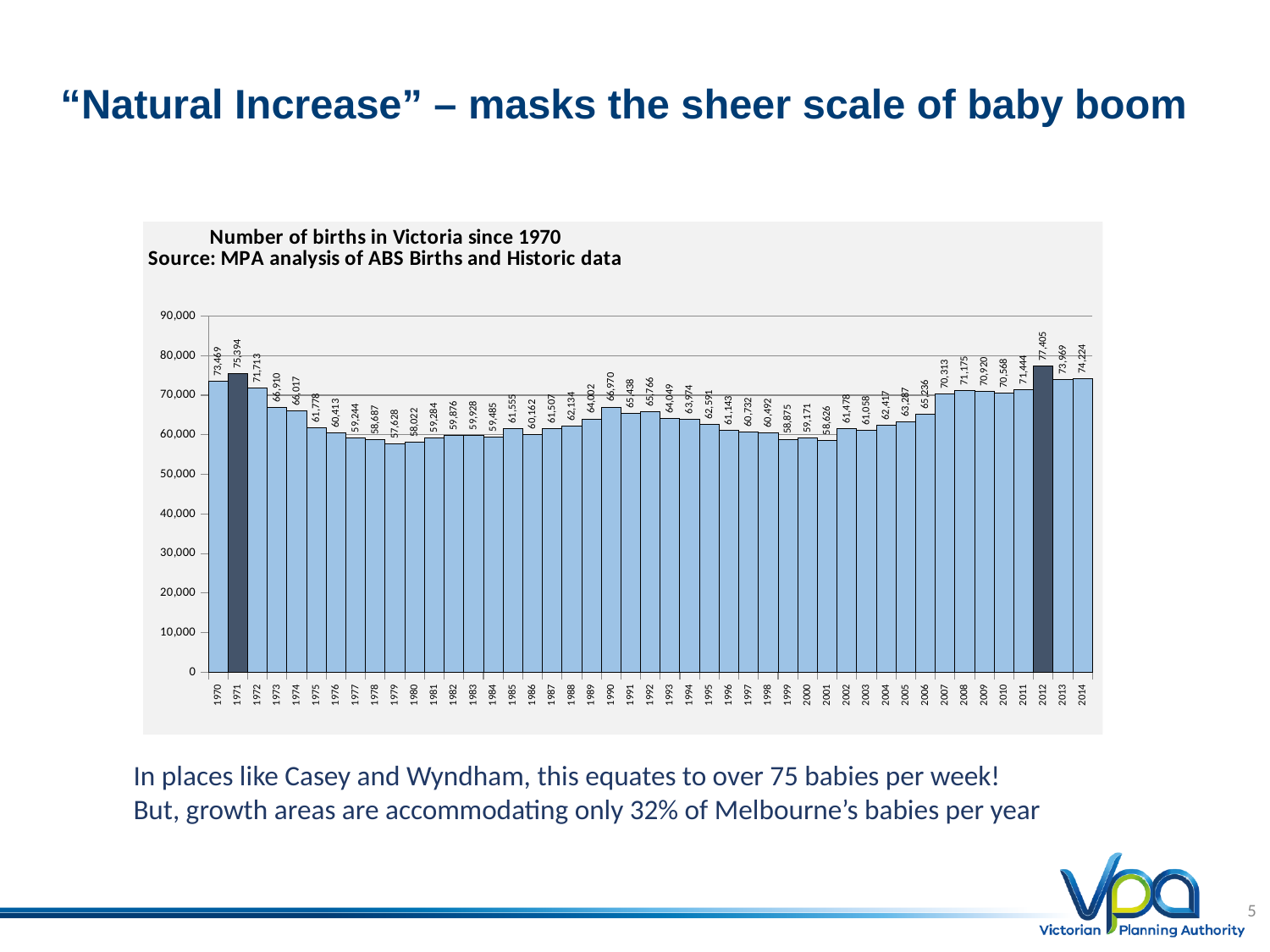
What is the difference in births between 2012 and 1971? 2,011 How many births were recorded in Victoria in 2012? 77,405 What is the number of births shown for 1979? 57,628 Which year had more births, 1990 or 2007? 2007 How many years (bars) are plotted in the chart? 45 From 1971 to 1979, do the number of births rise or fall? fall What kind of chart is shown on the slide? bar chart What is the difference in births between 2014 and 2013? 255 Is the value for 1979 greater or less than 60,000? less Which year has the lowest number of births? 1979 Which year has the highest number of births? 2012 What is the number of births shown for 1971? 75,394